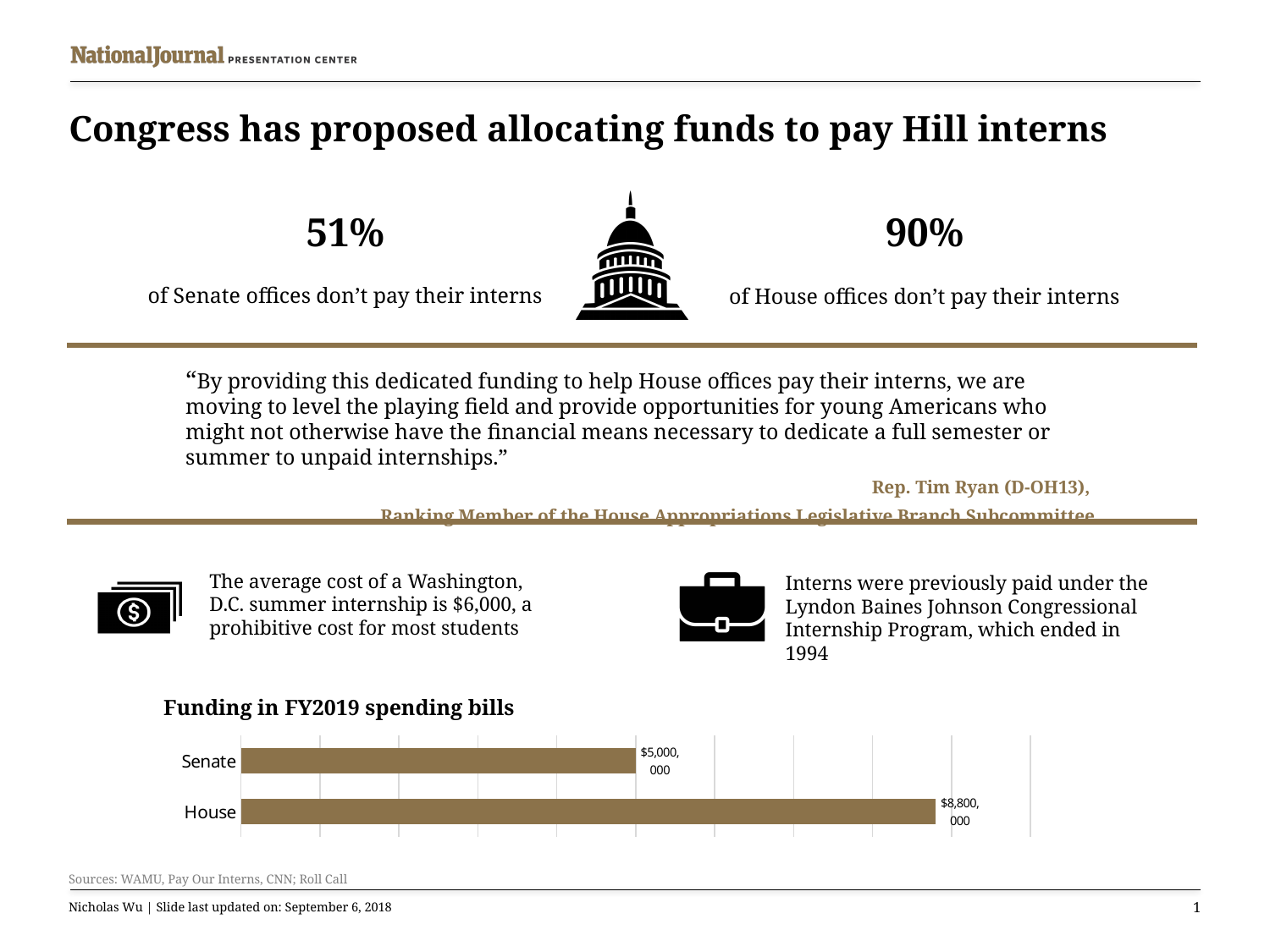
What is the funding value for the House in the 'Funding in FY2019 spending bills' chart? $8,800,000 How many categories are shown in the 'Funding in FY2019 spending bills' chart? 2 What is the funding value for the Senate in the 'Funding in FY2019 spending bills' chart? $5,000,000 Which category has the highest funding in the 'Funding in FY2019 spending bills' chart? House What is the difference between the House and Senate funding in the 'Funding in FY2019 spending bills' chart? $3,800,000 Which category has the lowest funding in the 'Funding in FY2019 spending bills' chart? Senate Is the funding for the House larger or smaller than the funding for the Senate in the 'Funding in FY2019 spending bills' chart? larger What is the title of the chart at the bottom of the slide? Funding in FY2019 spending bills What is the total funding across both categories in the 'Funding in FY2019 spending bills' chart? $13,800,000 What kind of chart is the 'Funding in FY2019 spending bills' chart? bar chart